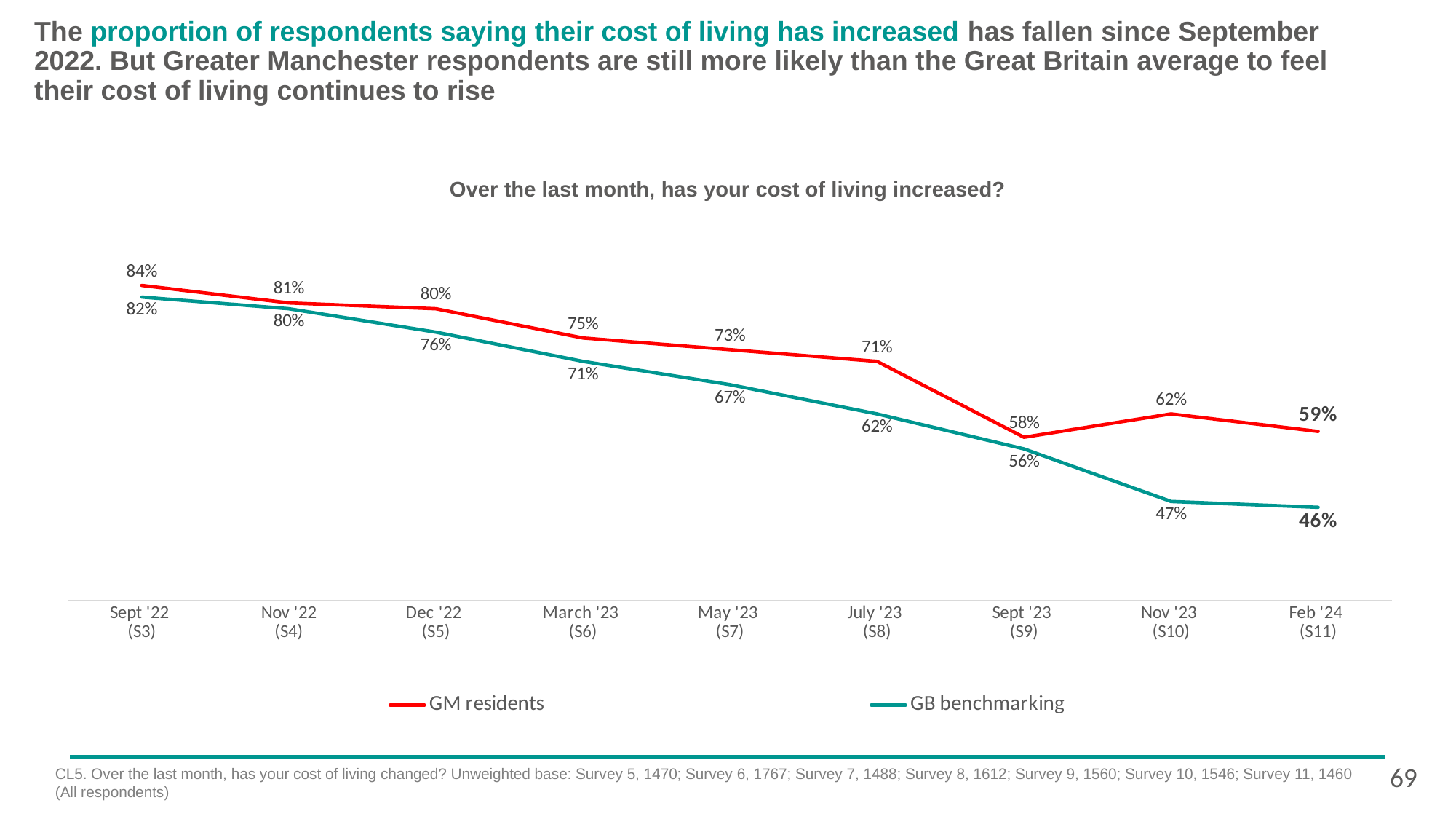
Which series has the higher value in Sept '23 (S9), GM residents or GB benchmarking? GM residents How many survey waves are plotted on the x axis? 9 Does the GB benchmarking series rise or fall from Sept '22 to Feb '24? Fall What kind of chart is shown on the slide? Line chart In which survey wave is the GB benchmarking value highest? Sept '22 (S3) In which survey wave is the GM residents value lowest? Sept '23 (S9) What is the value for GM residents in Sept '22 (S3)? 84% What is the value for GB benchmarking in July '23 (S8)? 62% How many series does the legend list? 2 What is the value for GM residents in Nov '23 (S10)? 62% What is the difference between GM residents and GB benchmarking in Feb '24 (S11)? 13 percentage points What is the value for GB benchmarking in Feb '24 (S11)? 46%